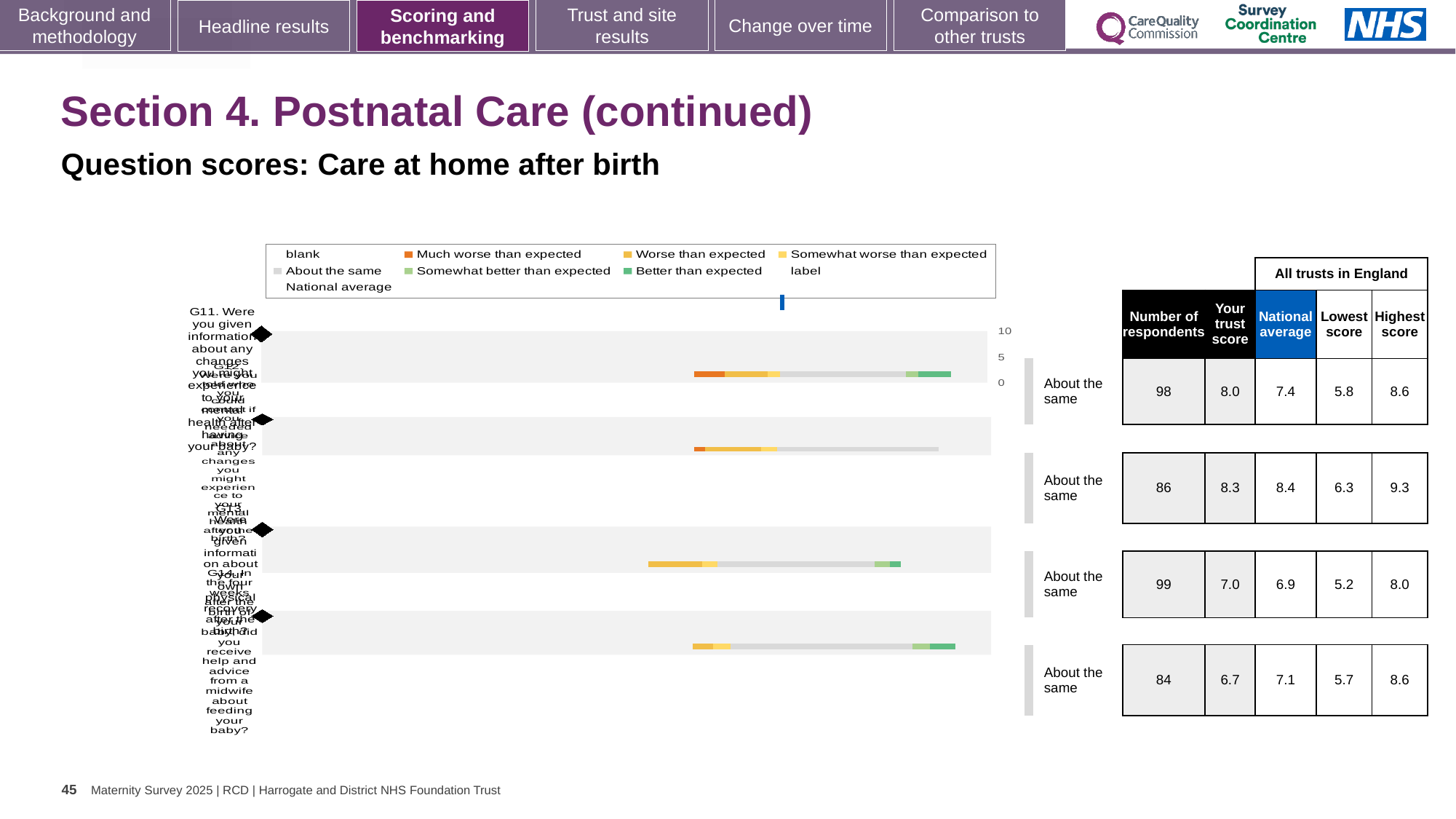
What kind of chart is shown on the slide? Bar chart What benchmark category is shown for each of the four question rows? About the same In the table beside the chart, what is the highest score for the second row? 9.3 In the table beside the chart, what is the lowest score for the third row? 5.2 In the chart legend, what colour represents 'Much worse than expected'? Orange In the table beside the chart, what is the trust score for the first row (G11, information about changes to mental health after having your baby)? 8.0 How many question rows (bars) does the chart show? 4 In the table beside the chart, what is the national average for the first row (G11)? 7.4 In the table beside the chart, how many respondents are listed for the second row? 86 In the chart legend, what colour represents 'Better than expected'? Green In the table beside the chart, which row has the highest 'Your trust score'? The second row (8.3) In the table beside the chart, what is the difference between the trust score and the national average for the first row (G11)? 0.6